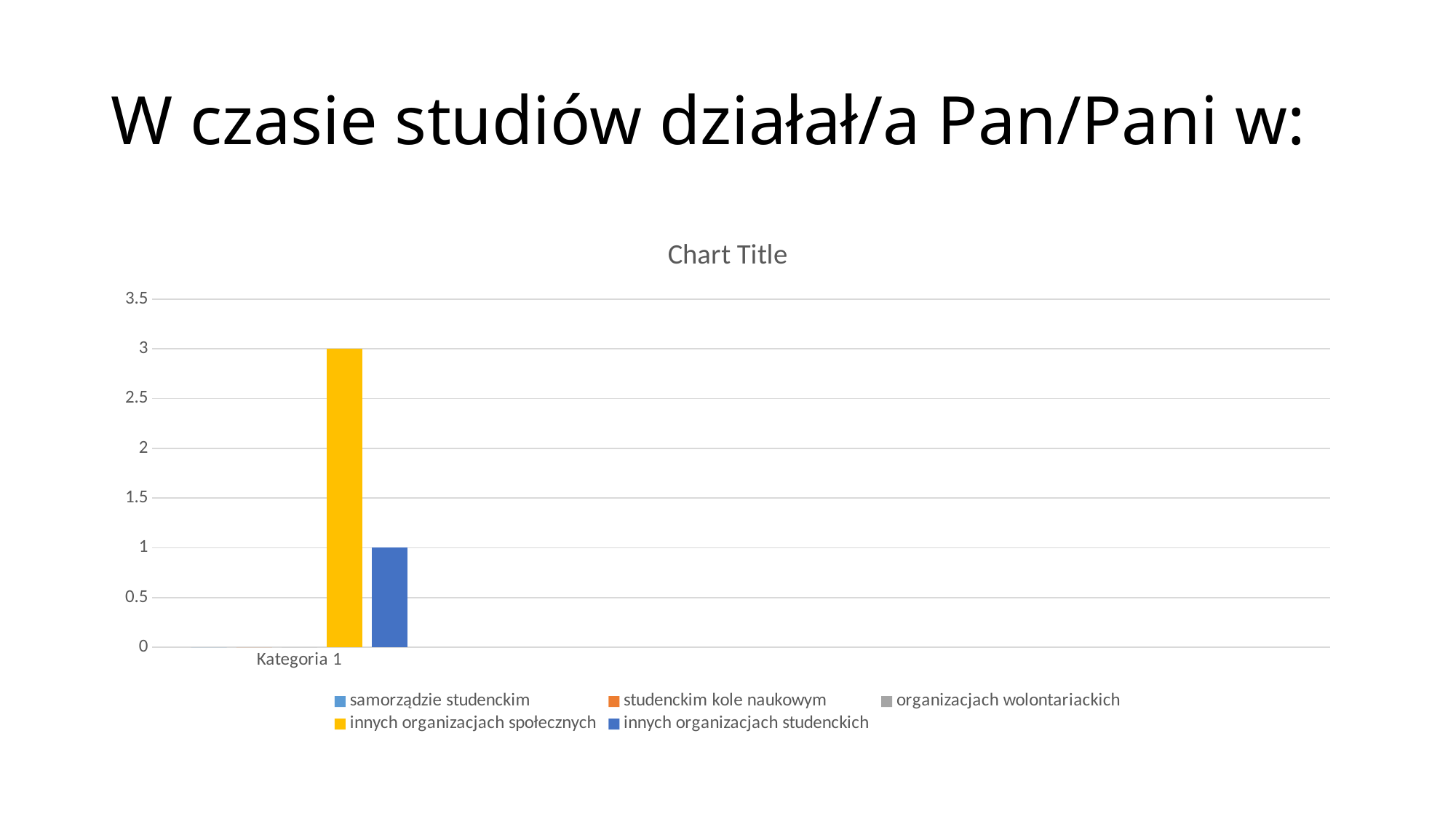
What is the title shown above the chart? Chart Title Is the value for "innych organizacjach studenckich" greater or less than 2? less Which is larger: the value for "innych organizacjach społecznych" or for "innych organizacjach studenckich"? innych organizacjach społecznych What kind of chart is shown on the slide? bar chart What is the value for "innych organizacjach społecznych" in Kategoria 1? 3 How many series does the legend list? 5 What is the value for "innych organizacjach studenckich" in Kategoria 1? 1 Which series has the highest value in Kategoria 1? innych organizacjach społecznych Is the value for "innych organizacjach społecznych" greater or less than 2? greater How many categories are shown on the x axis? 1 Which series is shown in yellow in the legend? innych organizacjach społecznych What is the difference between the values for "innych organizacjach społecznych" and "innych organizacjach studenckich"? 2